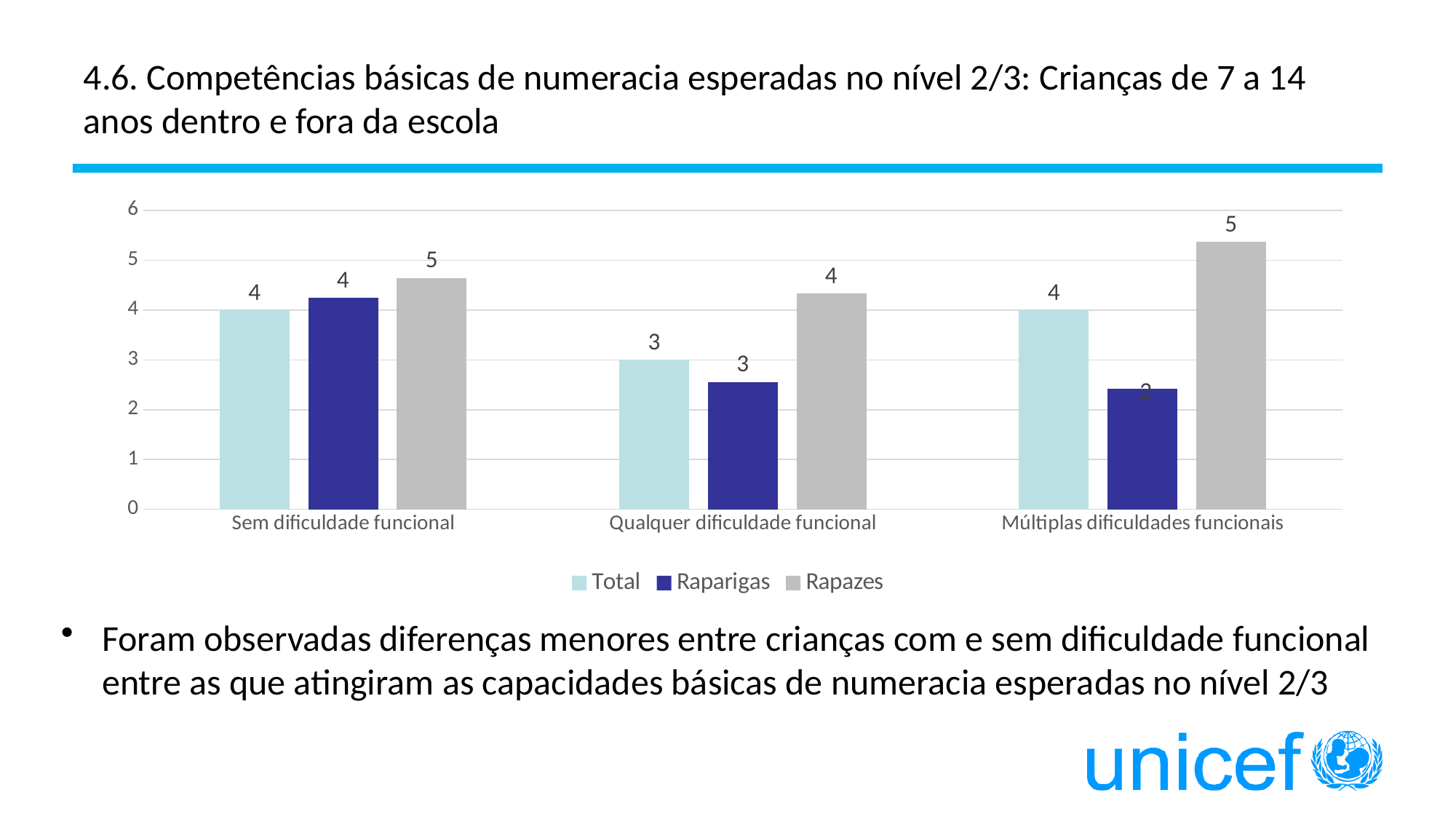
What is the value for Total in the 'Qualquer dificuldade funcional' category? 3 What is the value for Rapazes in the 'Qualquer dificuldade funcional' category? 4 What is the value for Raparigas in the 'Múltiplas dificuldades funcionais' category? 2 Which category has the lowest value for Raparigas? Múltiplas dificuldades funcionais What is the value for Rapazes in the 'Múltiplas dificuldades funcionais' category? 5 Which series is shown in dark blue in the legend? Raparigas How many categories are shown on the x axis? 3 What kind of chart is shown on the slide? bar chart In the 'Múltiplas dificuldades funcionais' category, which is larger, Raparigas or Rapazes? Rapazes How many series does the legend list? 3